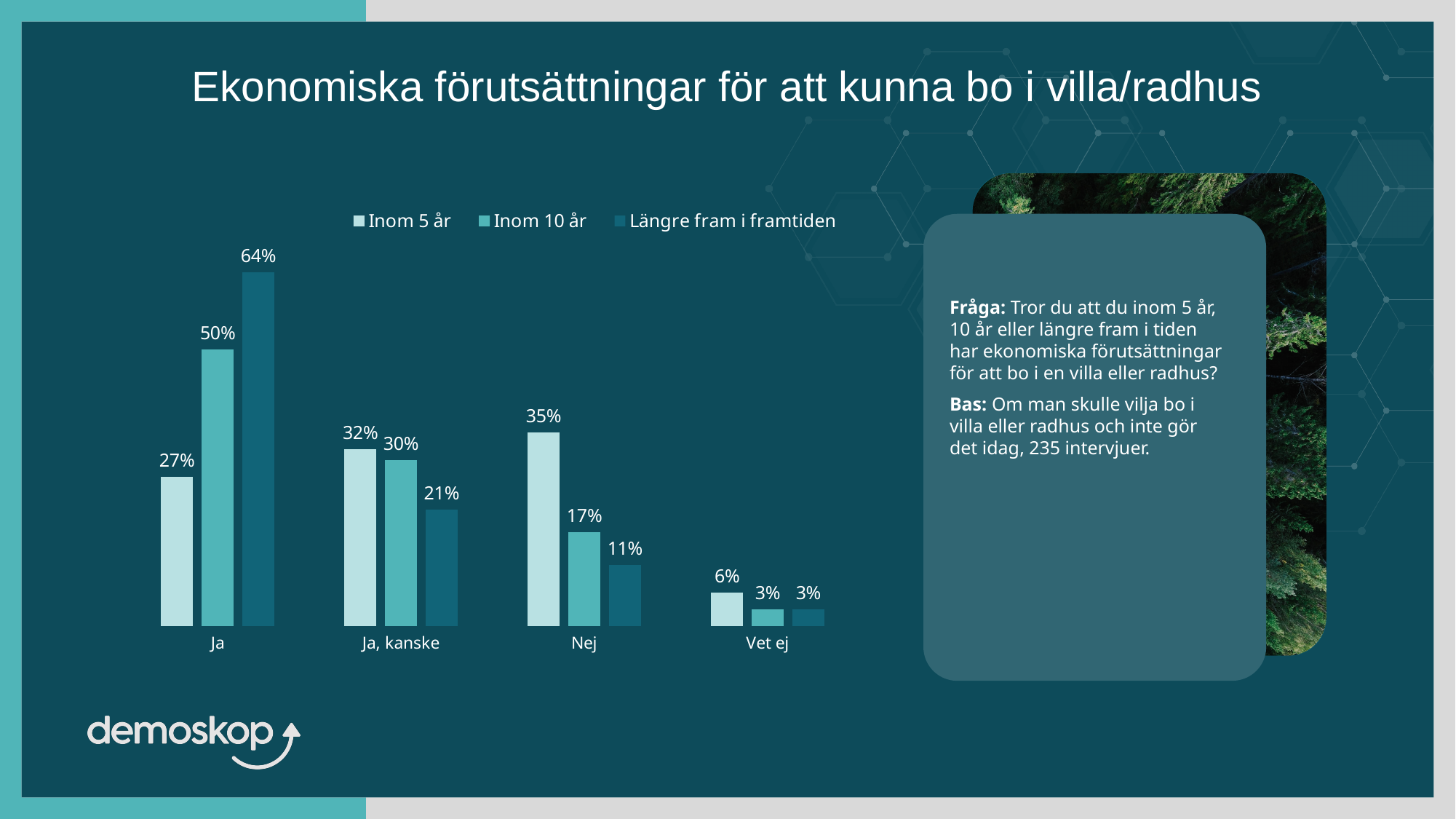
Which is larger for "Nej": the "Inom 10 år" value or the "Längre fram i framtiden" value? Inom 10 år What is the value for "Ja" in the "Längre fram i framtiden" series? 64% What is the title of the slide? Ekonomiska förutsättningar för att kunna bo i villa/radhus Does the "Inom 5 år" series rise or fall from "Nej" to "Vet ej"? Fall What is the difference between the "Längre fram i framtiden" and "Inom 5 år" values for "Ja"? 37% How many series does the legend list? 3 Which category has the lowest value in the "Längre fram i framtiden" series? Vet ej What kind of chart is shown on the slide? Bar chart How many categories are shown on the x axis? 4 Which category has the highest value in the "Inom 5 år" series? Nej What is the value for "Nej" in the "Inom 5 år" series? 35% What is the value for "Ja, kanske" in the "Inom 10 år" series? 30%